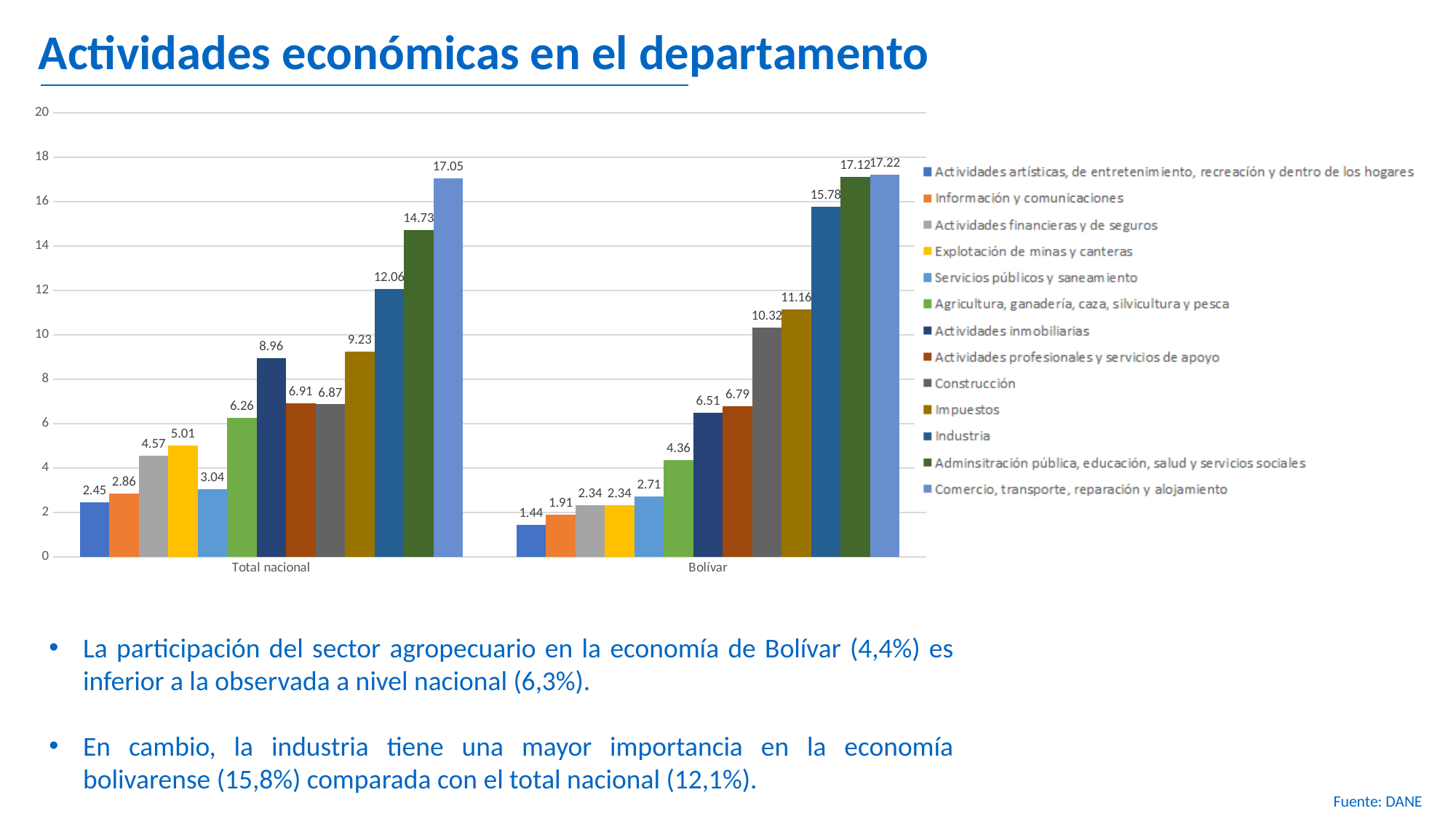
What is the value for Industria in the Bolívar group? 15.78 What is the difference between the Agricultura, ganadería, caza, silvicultura y pesca values for Total nacional and Bolívar? 1.90 What is the value for Agricultura, ganadería, caza, silvicultura y pesca in the Total nacional group? 6.26 Which is larger: Construcción in Bolívar or Construcción in Total nacional? Bolívar How many category groups are shown on the x axis? 2 What kind of chart is shown on the slide? Bar chart What is the value for Impuestos in the Bolívar group? 11.16 How many series does the legend list? 13 What is the source cited for the chart? DANE What is the difference between the Industria values for Bolívar and Total nacional? 3.72 Which series has the highest value in the Total nacional group? Comercio, transporte, reparación y alojamiento Which series has the lowest value in the Bolívar group? Actividades artísticas, de entretenimiento, recreación y dentro de los hogares